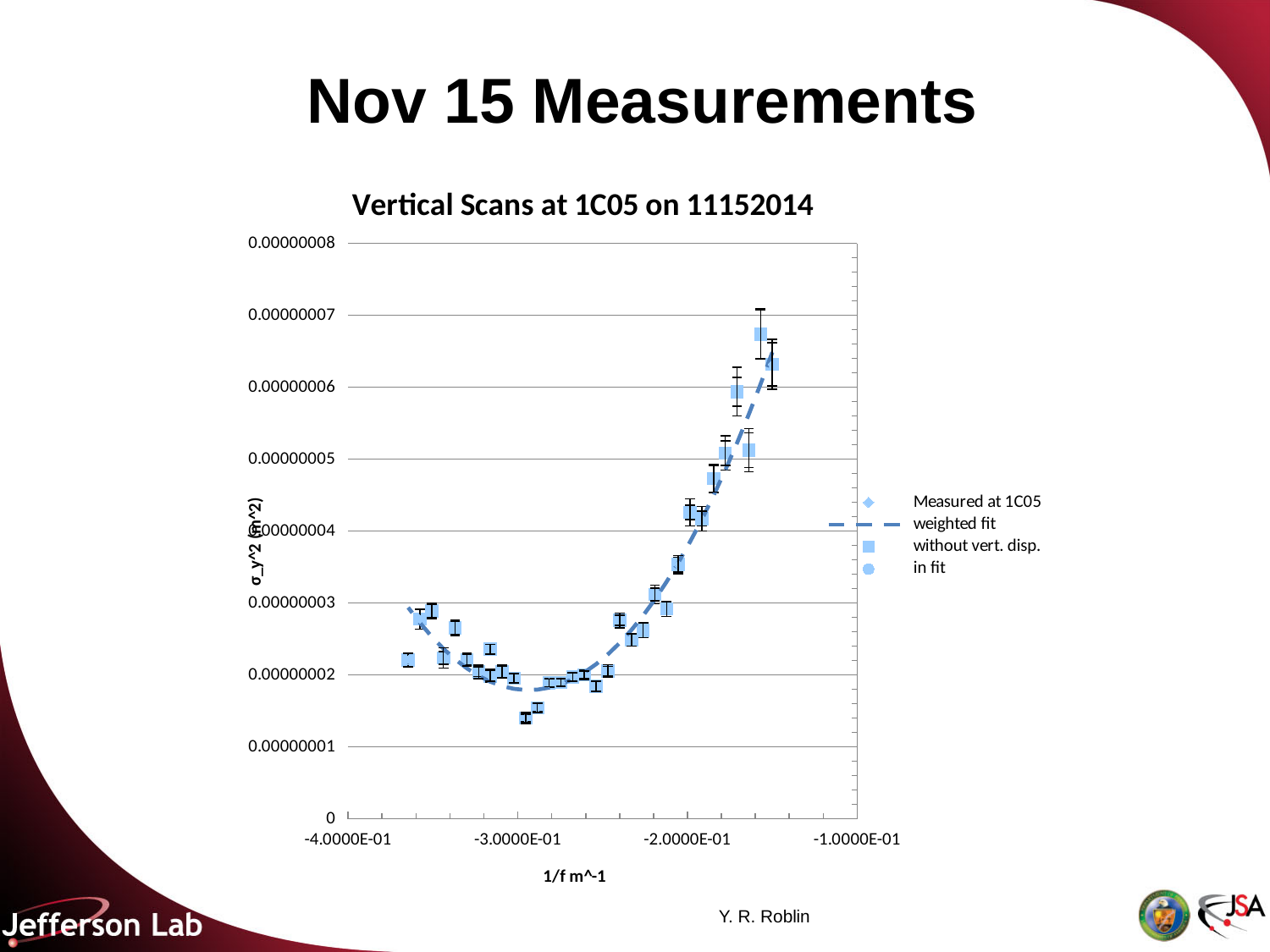
Is the highest plotted point on the chart greater or less than 0.00000006? greater Is the value of the highest plotted point greater or less than 0.00000008? less What is the title of the chart? Vertical Scans at 1C05 on 11152014 What kind of chart is shown on the slide? scatter chart How many entries does the chart legend list? 4 What is the label of the x axis? 1/f m^-1 What is the largest value shown on the y axis? 0.00000008 Are the plotted values near x = -1.5000E-01 higher or lower than the values near x = -3.0000E-01? higher Moving along the x axis from -3.0000E-01 toward -1.5000E-01, do the plotted values rise or fall? rise Is the lowest plotted point on the chart greater or less than 0.00000002? less